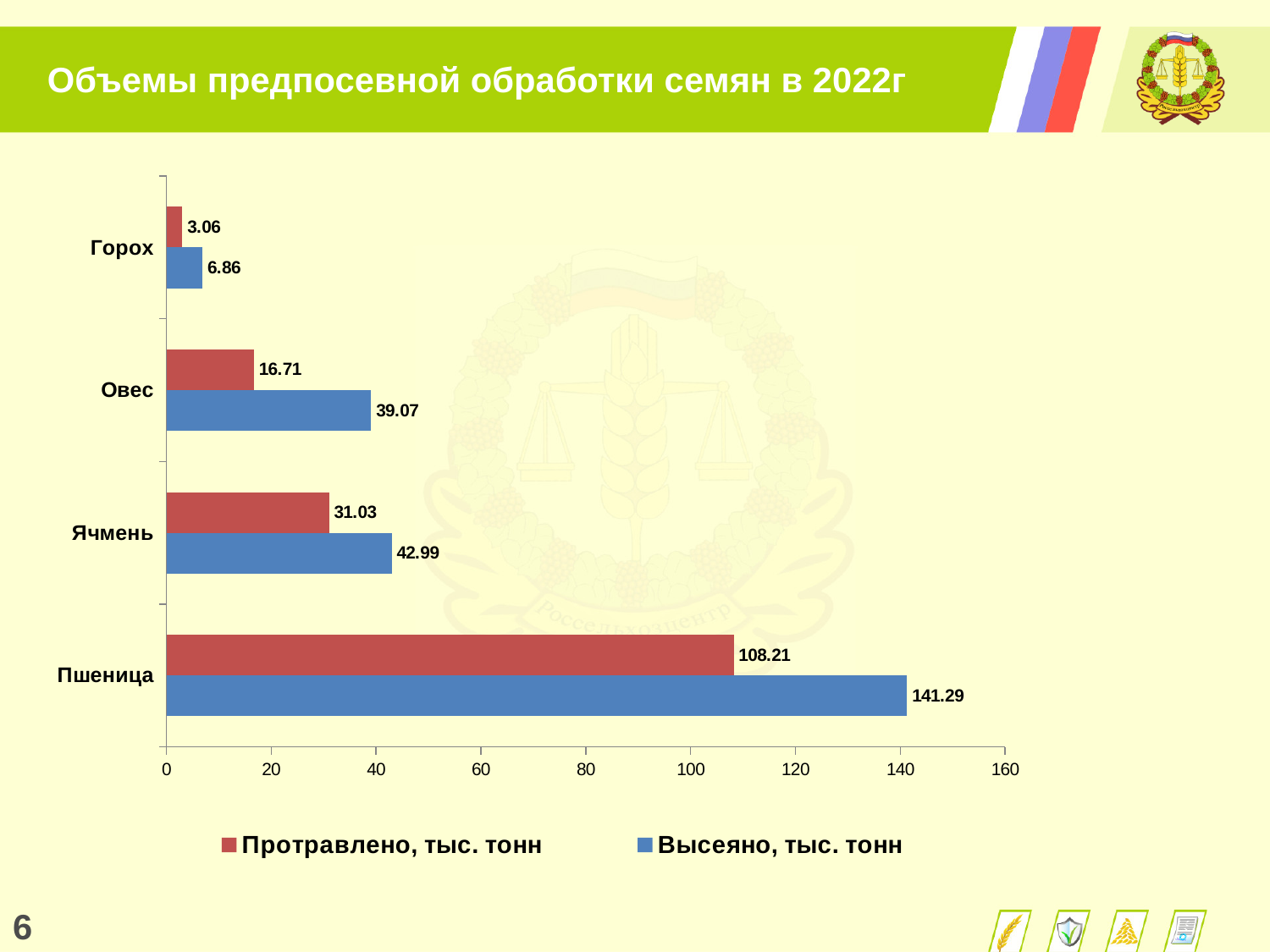
How many categories are shown on the chart? 4 What is the value of "Протравлено, тыс. тонн" for Овес? 16.71 What is the value of "Высеяно, тыс. тонн" for Пшеница? 141.29 What is the difference between "Высеяно, тыс. тонн" and "Протравлено, тыс. тонн" for Ячмень? 11.96 Which category has the lowest value for "Протравлено, тыс. тонн"? Горох How many series does the legend list? 2 What is the value of "Протравлено, тыс. тонн" for Горох? 3.06 Which is larger: "Протравлено, тыс. тонн" for Ячмень or "Высеяно, тыс. тонн" for Горох? Протравлено, тыс. тонн for Ячмень Which category has the highest value for "Высеяно, тыс. тонн"? Пшеница What kind of chart is shown on the slide? bar chart What is the difference between "Высеяно, тыс. тонн" and "Протравлено, тыс. тонн" for Пшеница? 33.08 Is the value of "Протравлено, тыс. тонн" for Пшеница greater or less than 100? greater